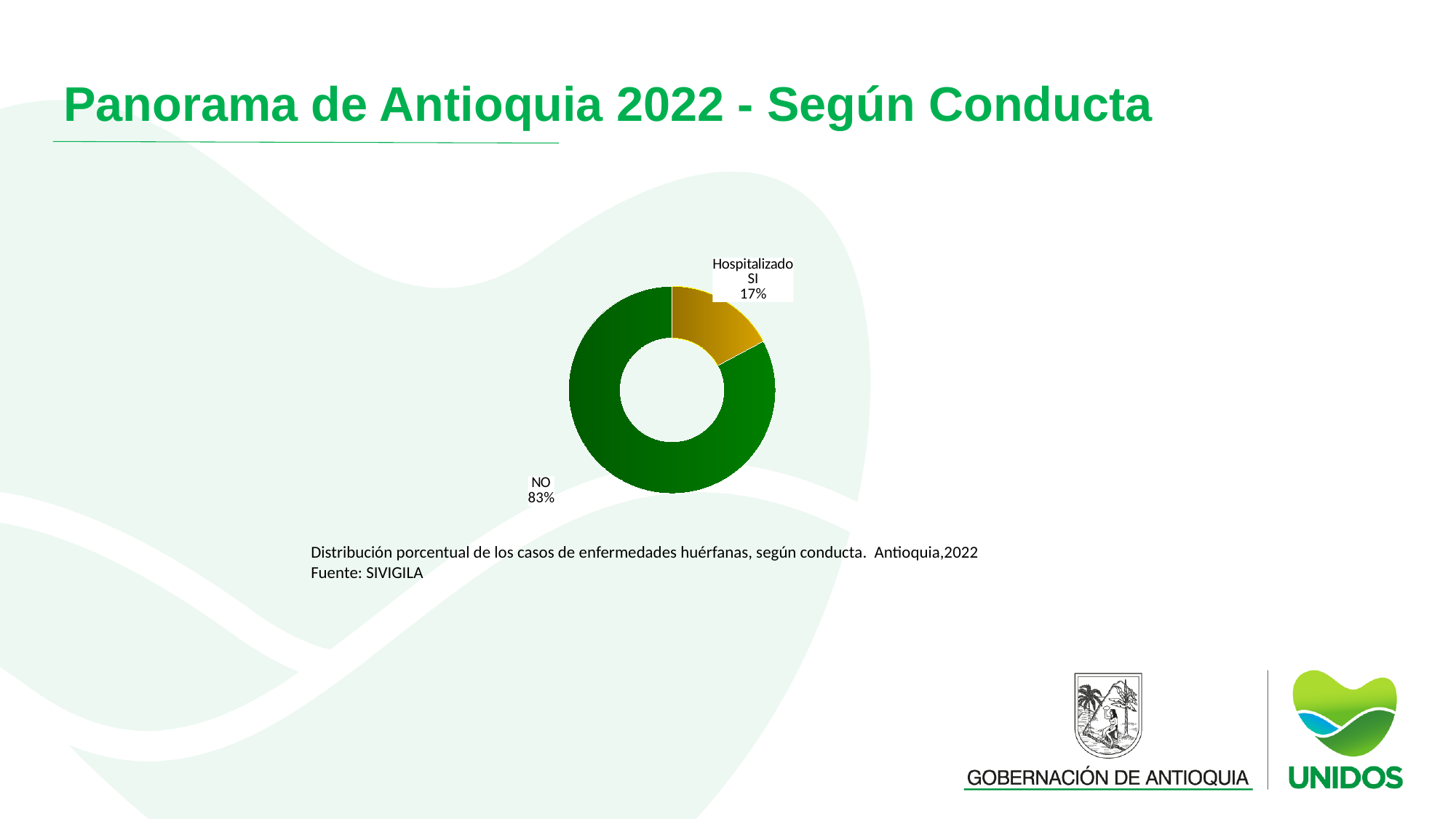
What kind of chart is shown on the slide? Doughnut (pie) chart What is the difference in percentage points between the NO share and the Hospitalizado SI share? 66 What colour is the Hospitalizado SI slice? Gold/yellow What percentage of cases were hospitalized (Hospitalizado SI)? 17% What percentage of cases were not hospitalized (NO)? 83% What is the source cited for the chart data? SIVIGILA Which category has the smallest share of the chart? Hospitalizado SI What share of the chart does the Hospitalizado SI slice represent? 17% How many categories are shown in the chart? 2 Which category has the largest share of the chart? NO Which is larger, the share for NO or the share for Hospitalizado SI? NO